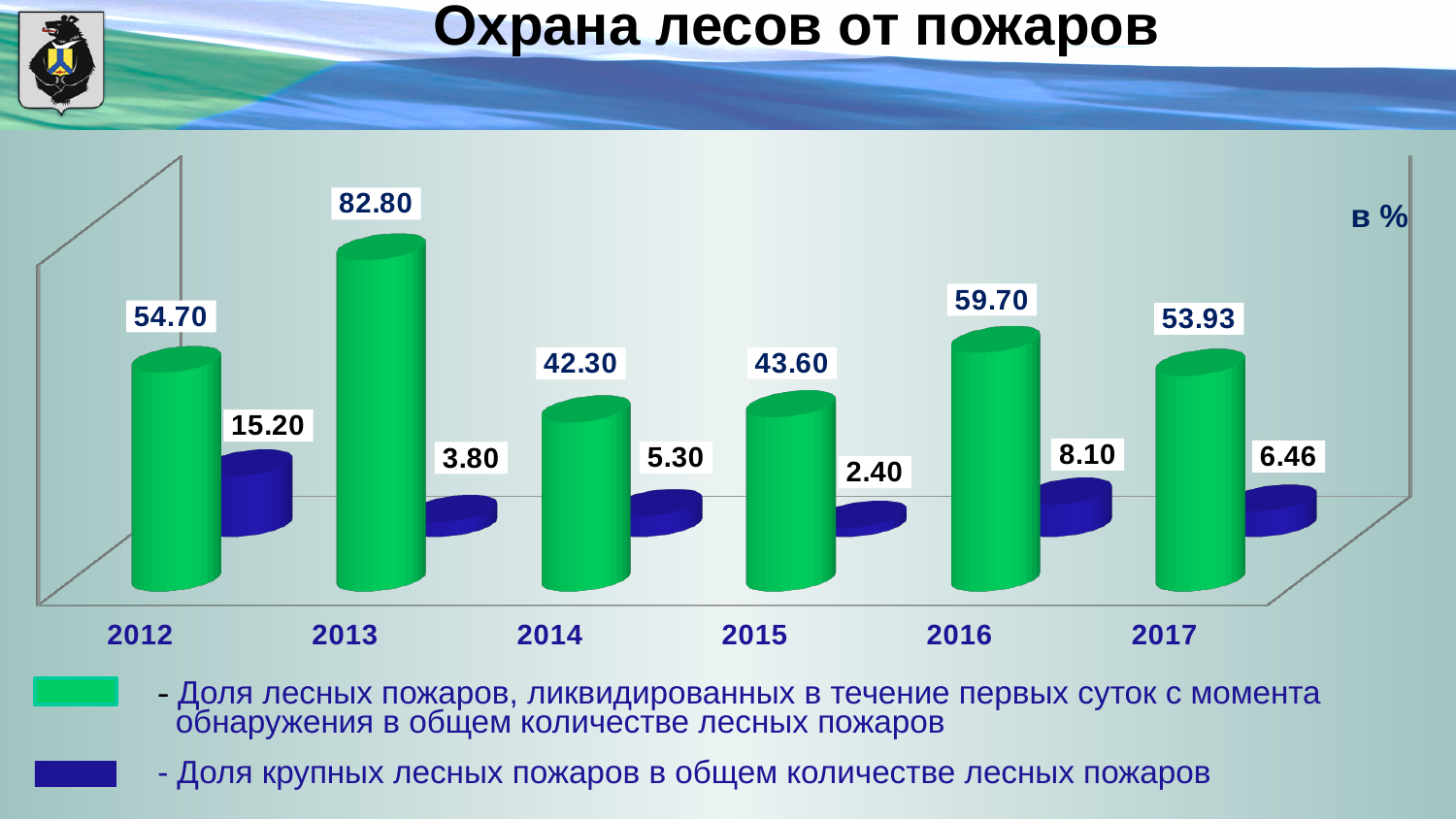
What is the value of the green series for 2017? 53.93 What is the title of the slide containing the chart? Охрана лесов от пожаров What unit is indicated in the top right corner of the chart? в % What kind of chart is shown on the slide? Bar chart In which year is the share of forest fires extinguished within the first day (green series) the highest? 2013 Which year has a larger value for the blue series, 2016 or 2017? 2016 What is the share of forest fires extinguished within the first day (green series) in 2013? 82.80 In which year is the share of large forest fires (blue series) the lowest? 2015 What is the share of large forest fires (blue series) in 2012? 15.20 What is the difference between the green series values for 2013 and 2014? 40.50 How many series does the legend list? 2 How many years are shown on the x axis of the chart? 6